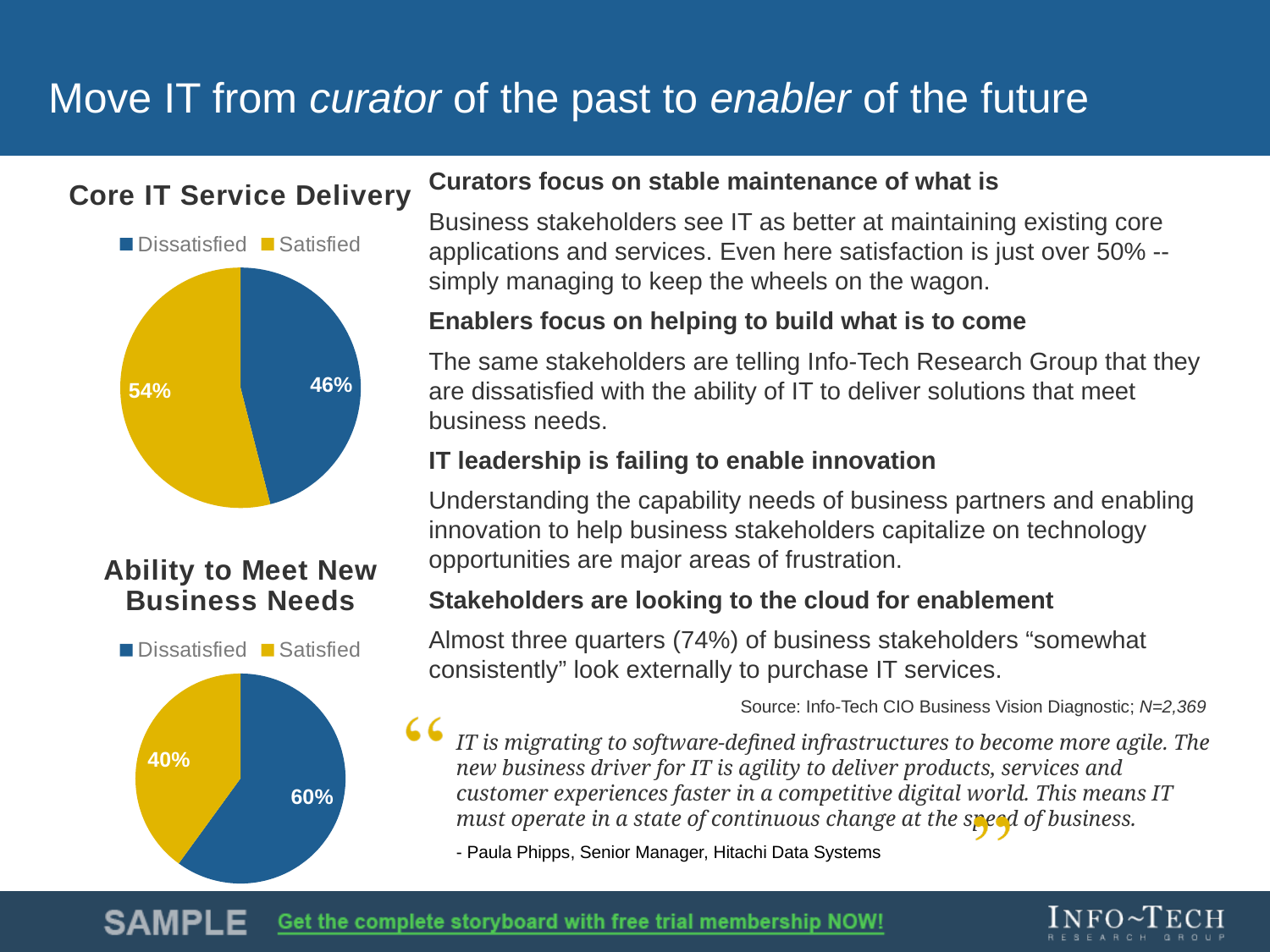
In the "Ability to Meet New Business Needs" chart, what percentage of stakeholders are Satisfied? 40% How many slices does the "Ability to Meet New Business Needs" pie chart have? 2 In the "Ability to Meet New Business Needs" chart, what colour is the Satisfied slice? Yellow How many entries does the legend of the "Core IT Service Delivery" chart list? 2 In the "Ability to Meet New Business Needs" chart, what percentage of stakeholders are Dissatisfied? 60% In the "Ability to Meet New Business Needs" chart, what is the difference between the Dissatisfied and Satisfied percentages? 20% What type of chart is the "Core IT Service Delivery" chart? Pie chart In the "Ability to Meet New Business Needs" chart, which slice is the largest? Dissatisfied In the "Core IT Service Delivery" chart, which slice is larger, Satisfied or Dissatisfied? Satisfied In the "Core IT Service Delivery" chart, what percentage of stakeholders are Satisfied? 54% In the "Core IT Service Delivery" chart, what percentage of stakeholders are Dissatisfied? 46% In the "Core IT Service Delivery" chart, what is the difference between the Satisfied and Dissatisfied percentages? 8%